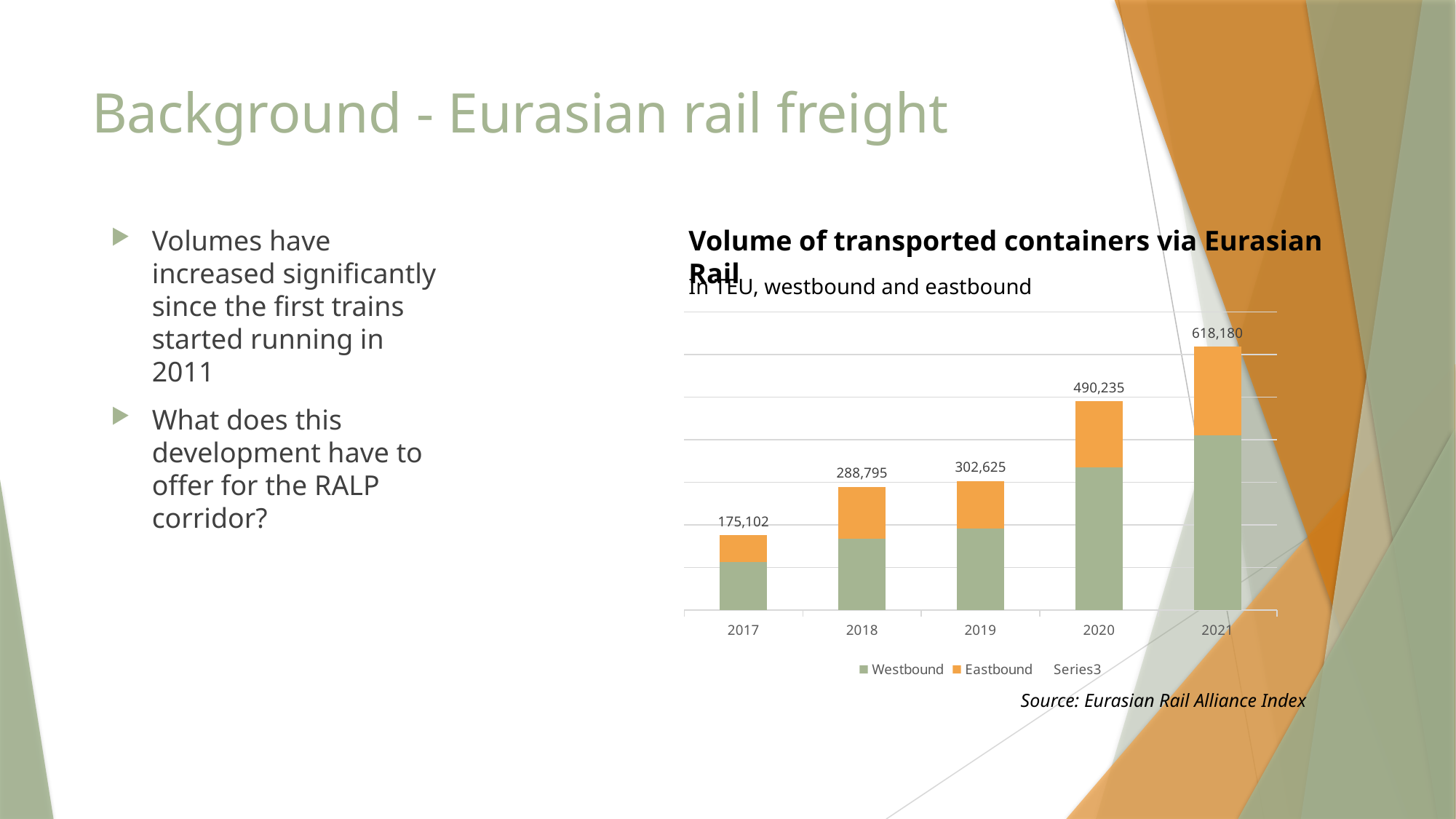
How many series does the chart legend list? 3 What is the total volume of transported containers shown for 2021? 618,180 By how much did the total volume increase from 2020 to 2021? 127,945 What is the total volume of transported containers shown for 2017? 175,102 What kind of chart is used to show the volume of transported containers? Stacked bar chart What is the difference between the total volumes for 2019 and 2018? 13,830 In 2020, which segment is larger, Westbound or Eastbound? Westbound What is the total volume of transported containers shown for 2019? 302,625 Which year has the lowest total volume of transported containers? 2017 Which year has the highest total volume of transported containers? 2021 Which year has the larger total volume, 2018 or 2019? 2019 How many years are shown on the x axis of the chart? 5